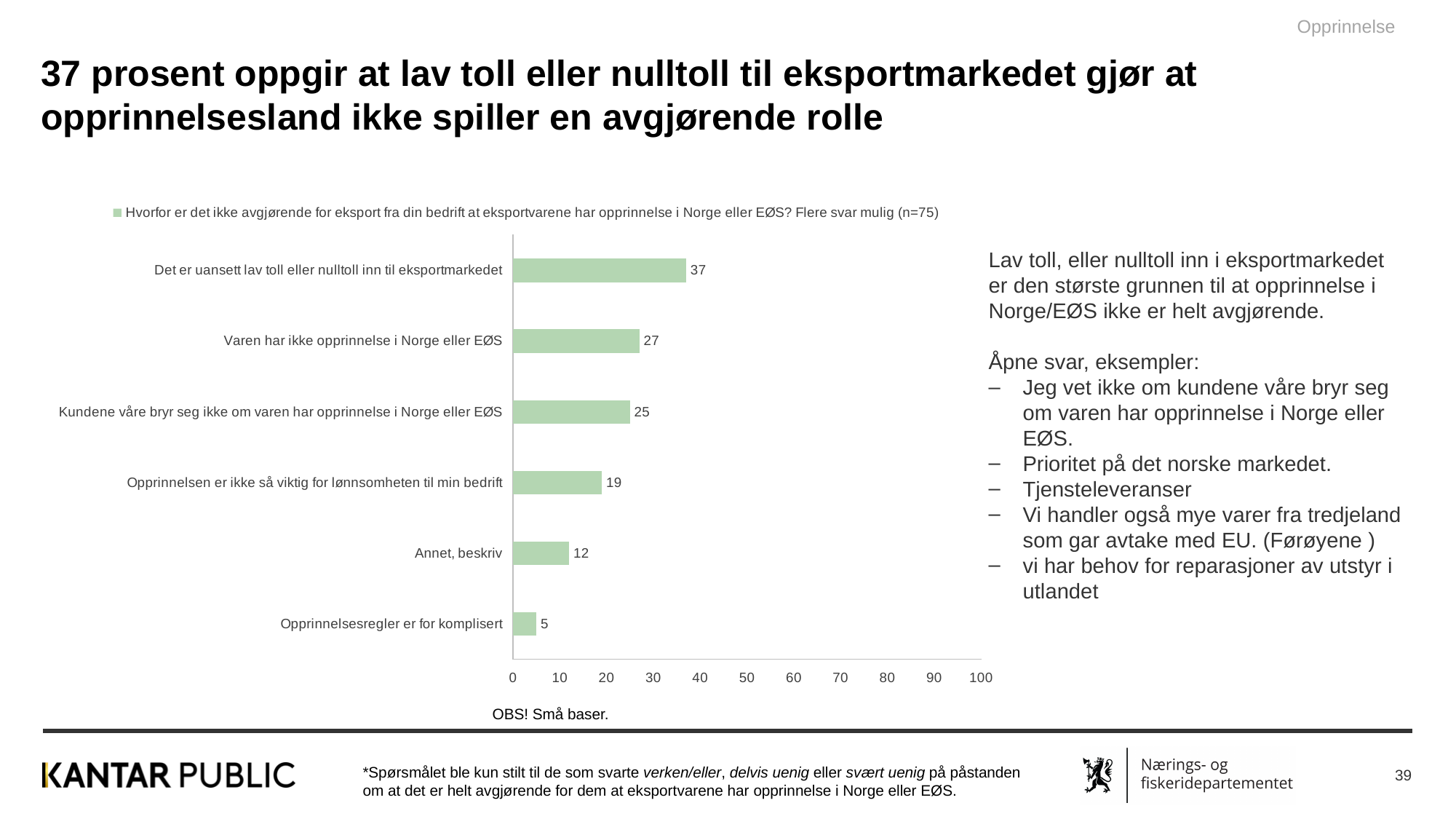
How many categories are shown in the chart? 6 What is the value for "Annet, beskriv"? 12 Which category has the highest value? Det er uansett lav toll eller nulltoll inn til eksportmarkedet What is the maximum value shown on the x axis? 100 Which is larger: the value for "Opprinnelsen er ikke så viktig for lønnsomheten til min bedrift" or the value for "Annet, beskriv"? Opprinnelsen er ikke så viktig for lønnsomheten til min bedrift What is the value for "Varen har ikke opprinnelse i Norge eller EØS"? 27 What is the value for "Det er uansett lav toll eller nulltoll inn til eksportmarkedet"? 37 Is the value for "Kundene våre bryr seg ikke om varen har opprinnelse i Norge eller EØS" greater or less than 30? less How many series does the legend list? 1 Which category has the lowest value? Opprinnelsesregler er for komplisert What is the difference between the values for "Varen har ikke opprinnelse i Norge eller EØS" and "Kundene våre bryr seg ikke om varen har opprinnelse i Norge eller EØS"? 2 What kind of chart is shown on the slide? Bar chart